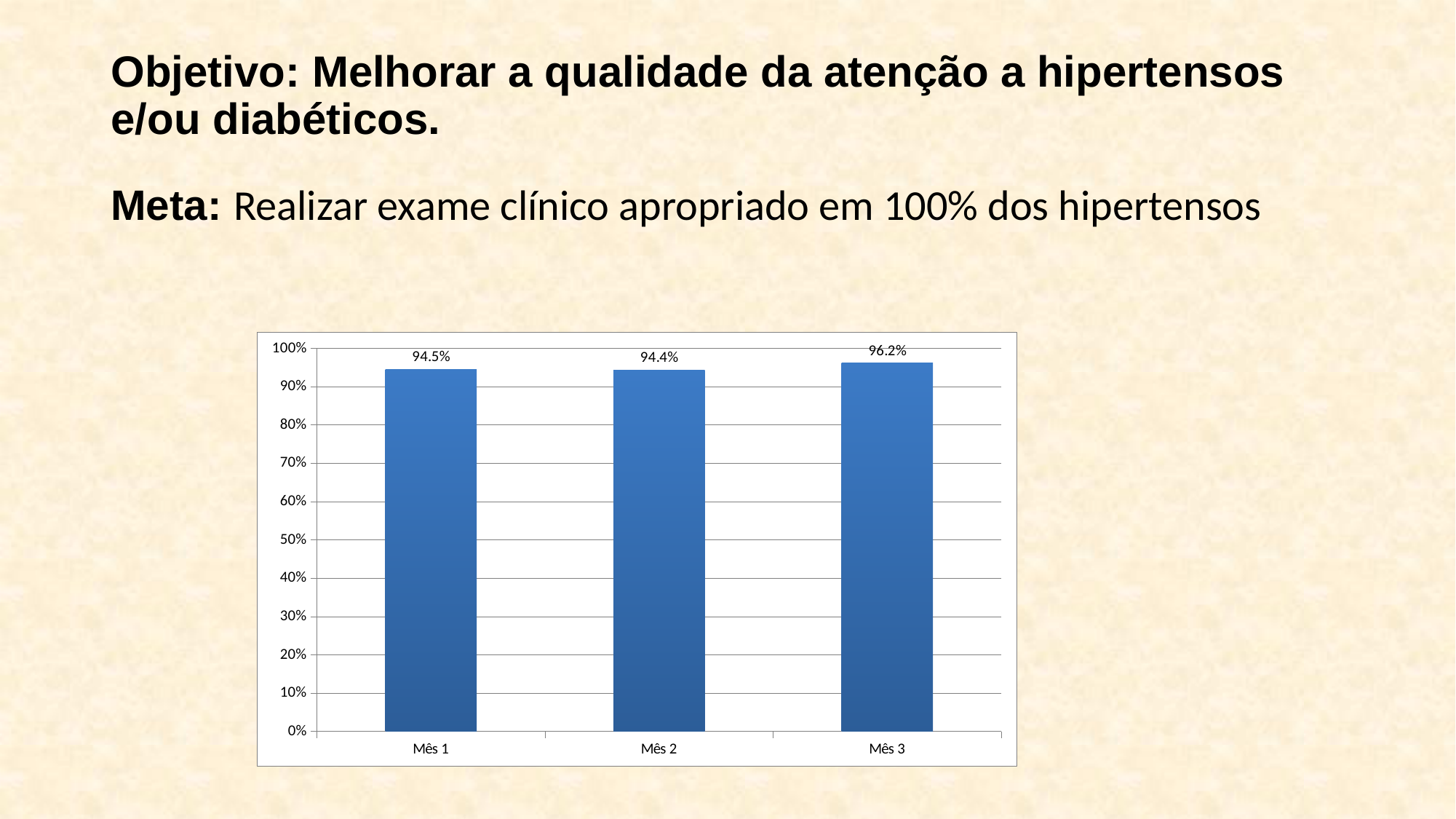
What is the highest value shown on the y axis? 100% Which is larger, the value for Mês 1 or the value for Mês 3? Mês 3 What is the value for Mês 3? 96.2% What is the difference between the values for Mês 3 and Mês 1? 1.7 percentage points What is the difference between the values for Mês 3 and Mês 2? 1.8 percentage points What is the value for Mês 2? 94.4% What kind of chart is shown on the slide? Bar chart What is the value for Mês 1? 94.5% Is the value for Mês 2 greater or less than 90%? greater Does the value rise or fall from Mês 2 to Mês 3? Rise Which month has the highest value? Mês 3 How many months are shown on the x axis? 3